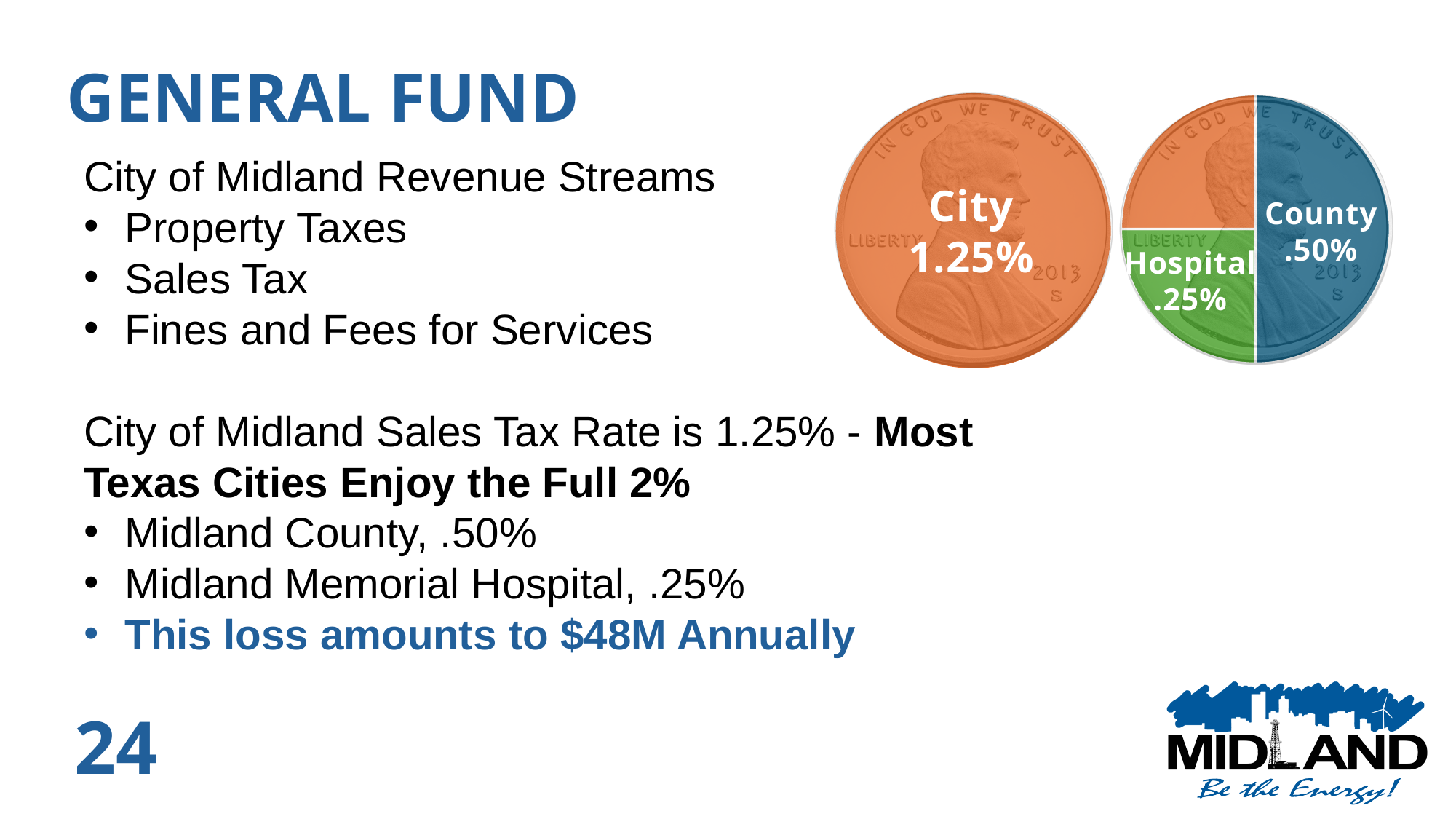
On the penny chart, what rate is shown for the Hospital? .25% On the penny chart, what rate is shown for the County? .50% On the penny chart, what sales tax rate is shown for the City? 1.25% On the penny chart, what is the difference between the County rate and the Hospital rate? .25% On the penny chart, which is larger, the County rate or the Hospital rate? County On the penny chart, what colour is the County segment? blue On the penny chart, what is the difference between the City rate and the County rate? .75% On the penny chart, what colour is the Hospital segment? green On the penny chart, which labeled segment has the highest rate? City On the penny chart, which labeled segment has the lowest rate? Hospital On the penny chart, how many labeled segments are there across the two pennies? 3 What kind of chart is drawn on the second penny? pie chart